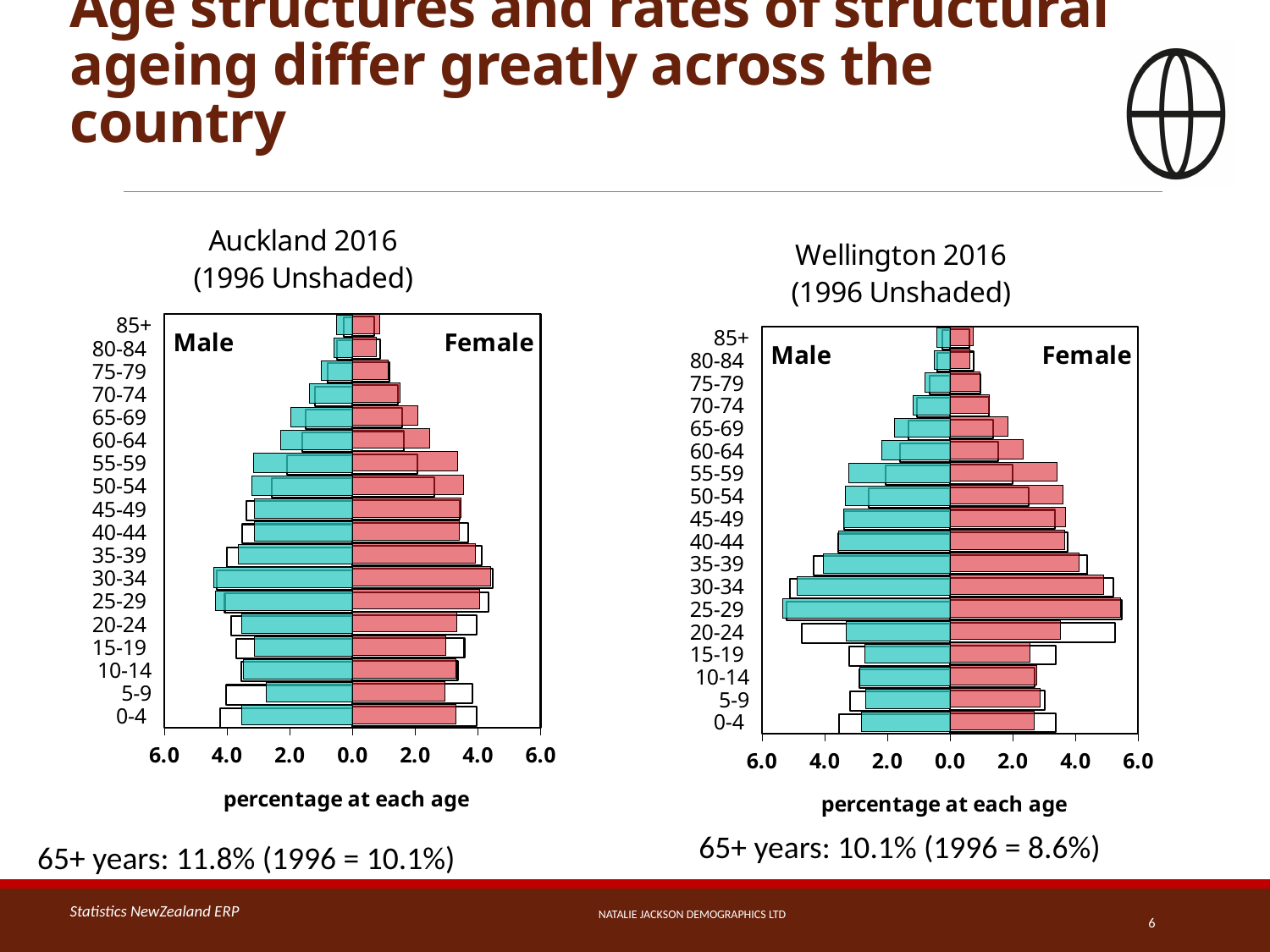
On the Wellington 2016 chart, which age group has the largest female bar? 25-29 On the Wellington 2016 chart, which age group has the smallest male bar? 85+ On the Auckland 2016 chart, is the male value for 85+ greater or less than 2.0? less What kind of chart is the Auckland 2016 chart? bar chart On the Wellington 2016 chart, what year do the unshaded bars represent? 1996 Which chart has the larger female bar for the 25-29 age group, Auckland 2016 or Wellington 2016? Wellington 2016 On the Auckland 2016 chart, which age group has the largest female bar? 30-34 On the Wellington 2016 chart, which is larger: the male bar for 25-29 or the male bar for 20-24? 25-29 What is the x-axis label on the Auckland 2016 chart? percentage at each age On the Wellington 2016 chart, is the female value for 25-29 greater or less than 4.0? greater On the Auckland 2016 chart, is the female value for 30-34 greater or less than 4.0? greater How many age groups are shown on the Wellington 2016 chart? 18